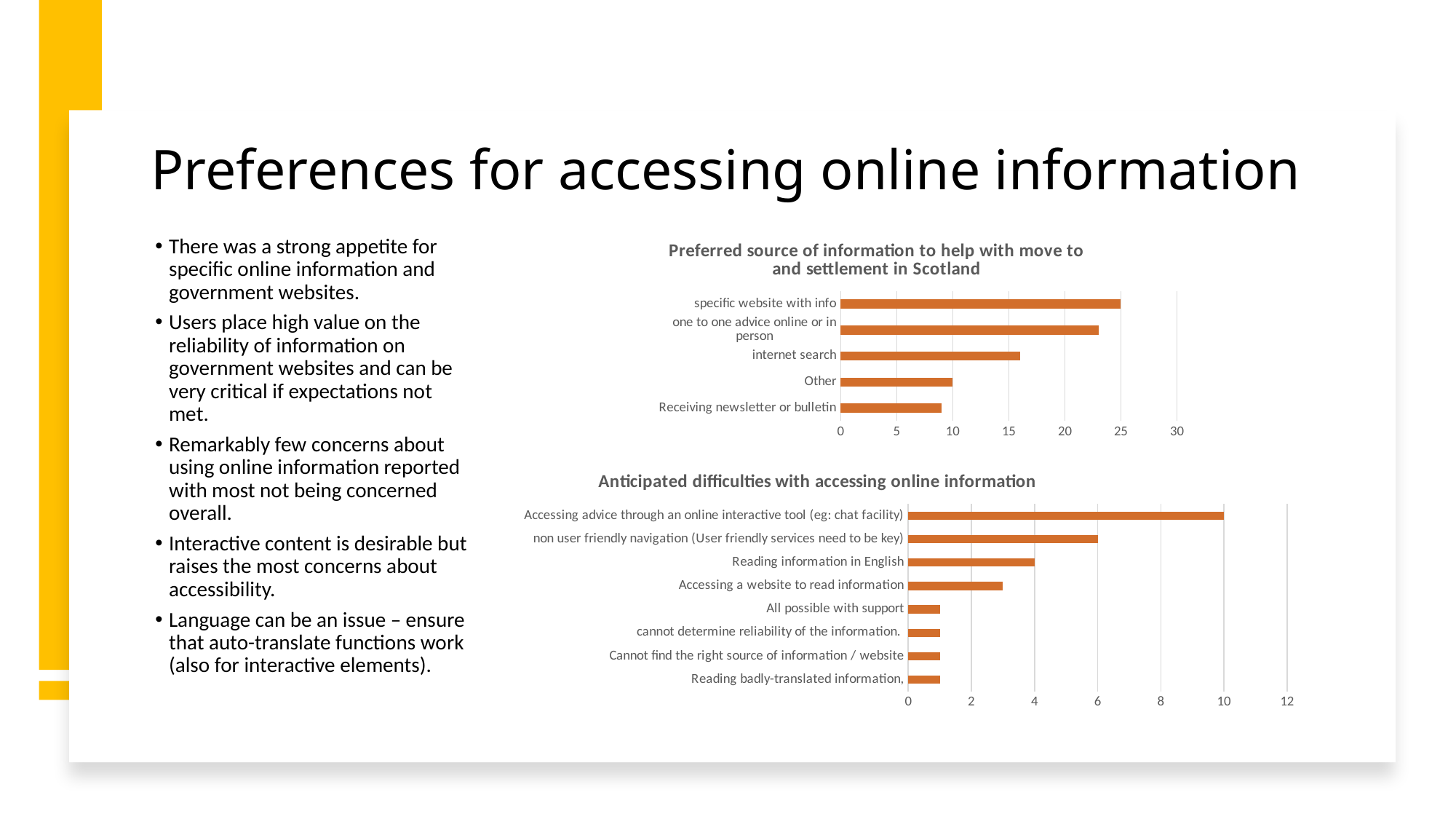
What type of chart is the 'Preferred source of information to help with move to and settlement in Scotland' chart? bar chart In the 'Preferred source of information' chart, is the value for 'internet search' greater or less than 15? greater In the 'Anticipated difficulties with accessing online information' chart, is the value for 'Accessing a website to read information' greater or less than 2? greater In the 'Anticipated difficulties with accessing online information' chart, what is the value for 'non user friendly navigation (User friendly services need to be key)'? 6 In the 'Preferred source of information' chart, which is larger: 'one to one advice online or in person' or 'internet search'? one to one advice online or in person How many categories are shown in the 'Preferred source of information' chart? 5 In the 'Preferred source of information' chart, which category has the lowest value? Receiving newsletter or bulletin In the 'Preferred source of information' chart, which category has the highest value? specific website with info In the 'Anticipated difficulties with accessing online information' chart, which category has the highest value? Accessing advice through an online interactive tool (eg: chat facility) How many categories are shown in the 'Anticipated difficulties with accessing online information' chart? 8 In the 'Anticipated difficulties with accessing online information' chart, what is the value for 'Accessing advice through an online interactive tool (eg: chat facility)'? 10 What is the title of the lower chart on the slide? Anticipated difficulties with accessing online information